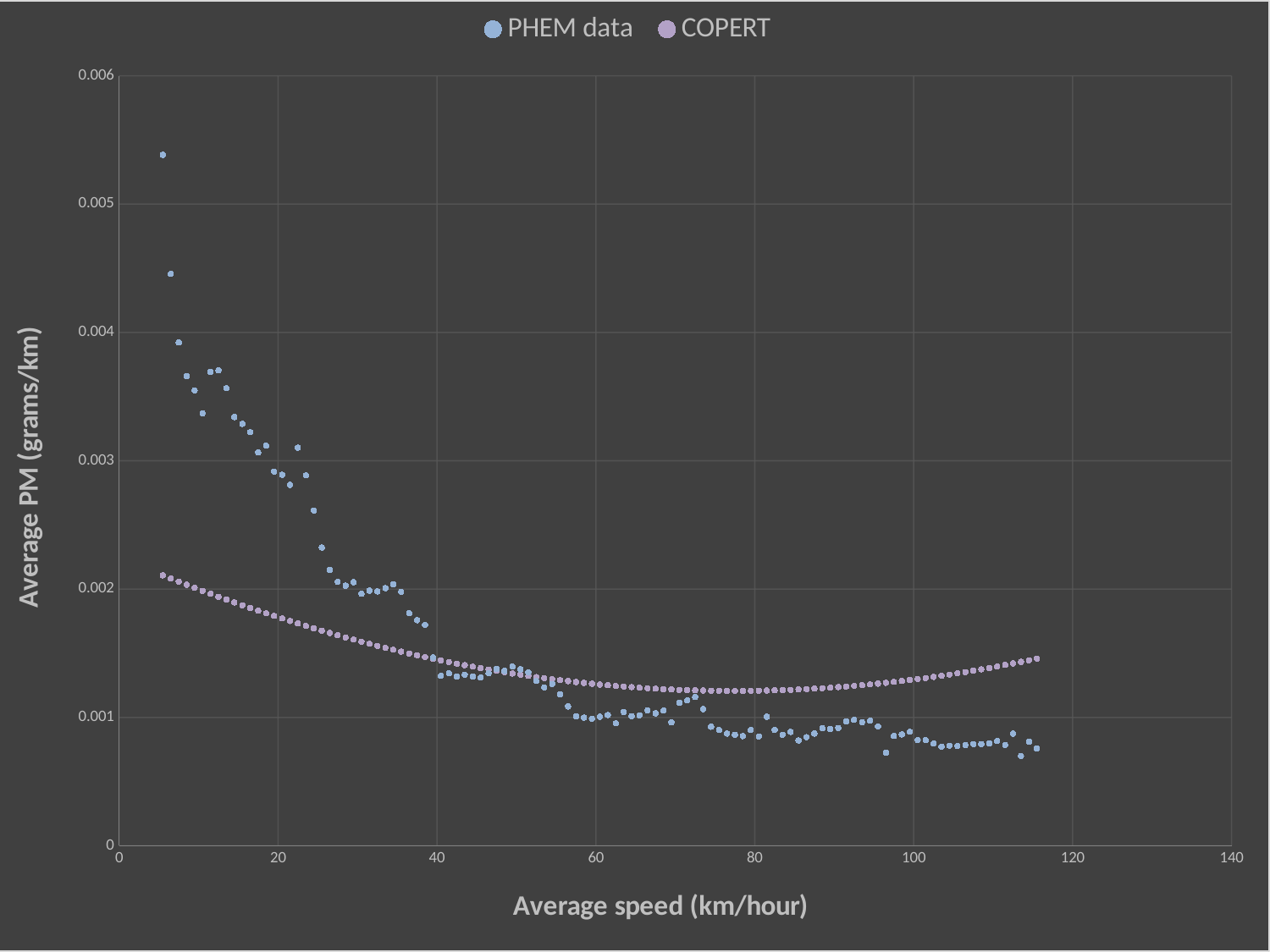
What kind of chart is shown on the slide? Scatter chart Is the COPERT value at 80 km/hour greater or less than 0.001? greater What are the two series named in the legend? PHEM data and COPERT Do the PHEM data values generally rise or fall as average speed increases? fall Is the PHEM data value at 80 km/hour greater or less than 0.001? less At 100 km/hour, which series has the larger value, PHEM data or COPERT? COPERT Is the PHEM data value at 10 km/hour greater or less than 0.003? greater How many series does the legend list? 2 What is the title of the x axis? Average speed (km/hour) At 20 km/hour, which series has the larger value, PHEM data or COPERT? PHEM data